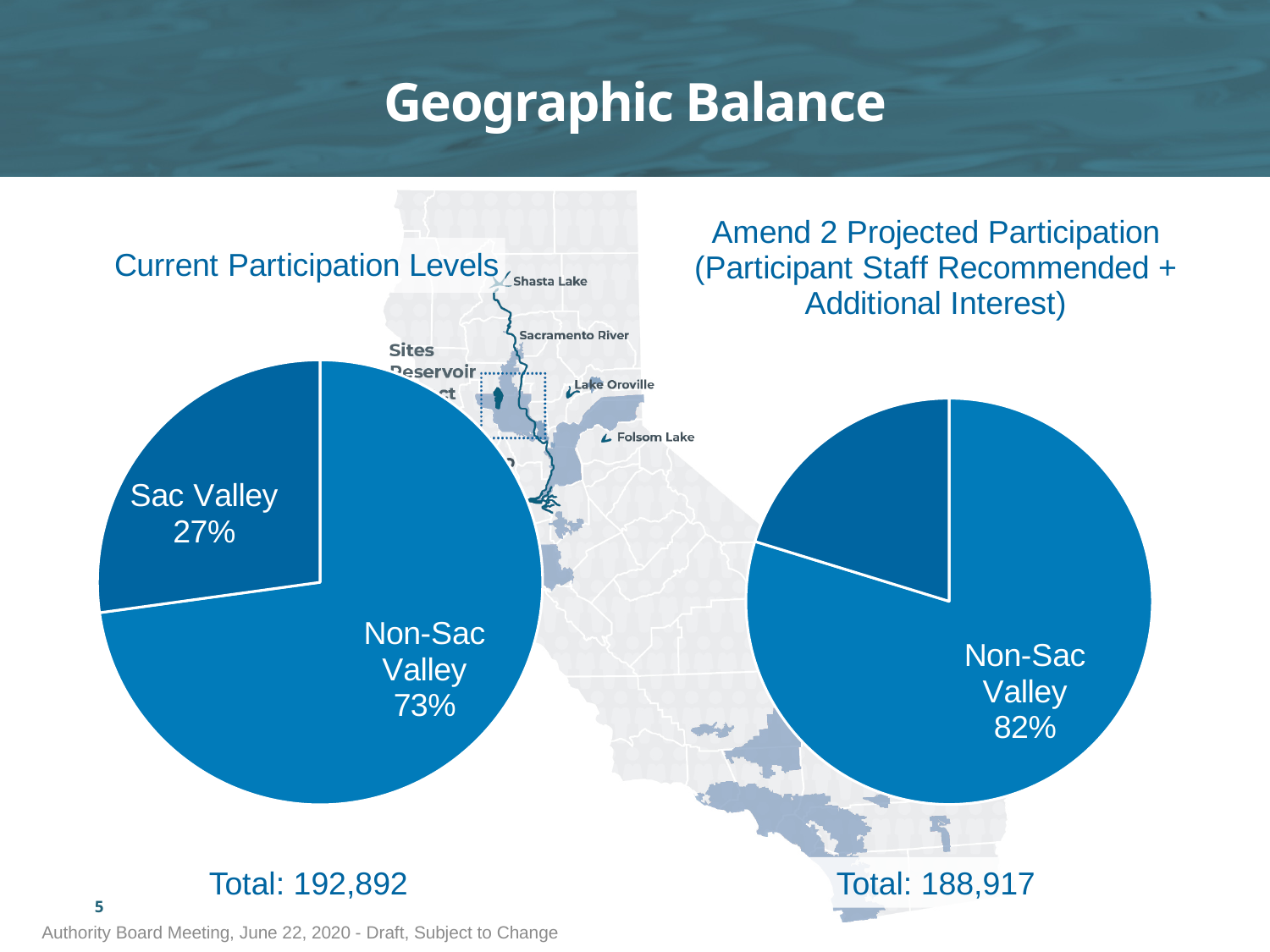
What total is shown below the "Amend 2 Projected Participation" chart? 188,917 In the "Amend 2 Projected Participation" chart, what share does Non-Sac Valley have? 82% What kind of chart is the "Current Participation Levels" chart? Pie chart In the "Current Participation Levels" chart, which slice is the smallest? Sac Valley In the "Current Participation Levels" chart, what share does Non-Sac Valley have? 73% In the "Current Participation Levels" chart, what is the difference in percentage points between Non-Sac Valley and Sac Valley? 46 percentage points Is the Non-Sac Valley share larger in the "Current Participation Levels" chart or in the "Amend 2 Projected Participation" chart? Amend 2 Projected Participation In the "Current Participation Levels" chart, what share does Sac Valley have? 27% In the "Current Participation Levels" chart, which slice is the largest? Non-Sac Valley How many slices does the "Current Participation Levels" pie chart have? 2 What total is shown below the "Current Participation Levels" chart? 192,892 In the "Amend 2 Projected Participation" chart, which slice is the largest? Non-Sac Valley